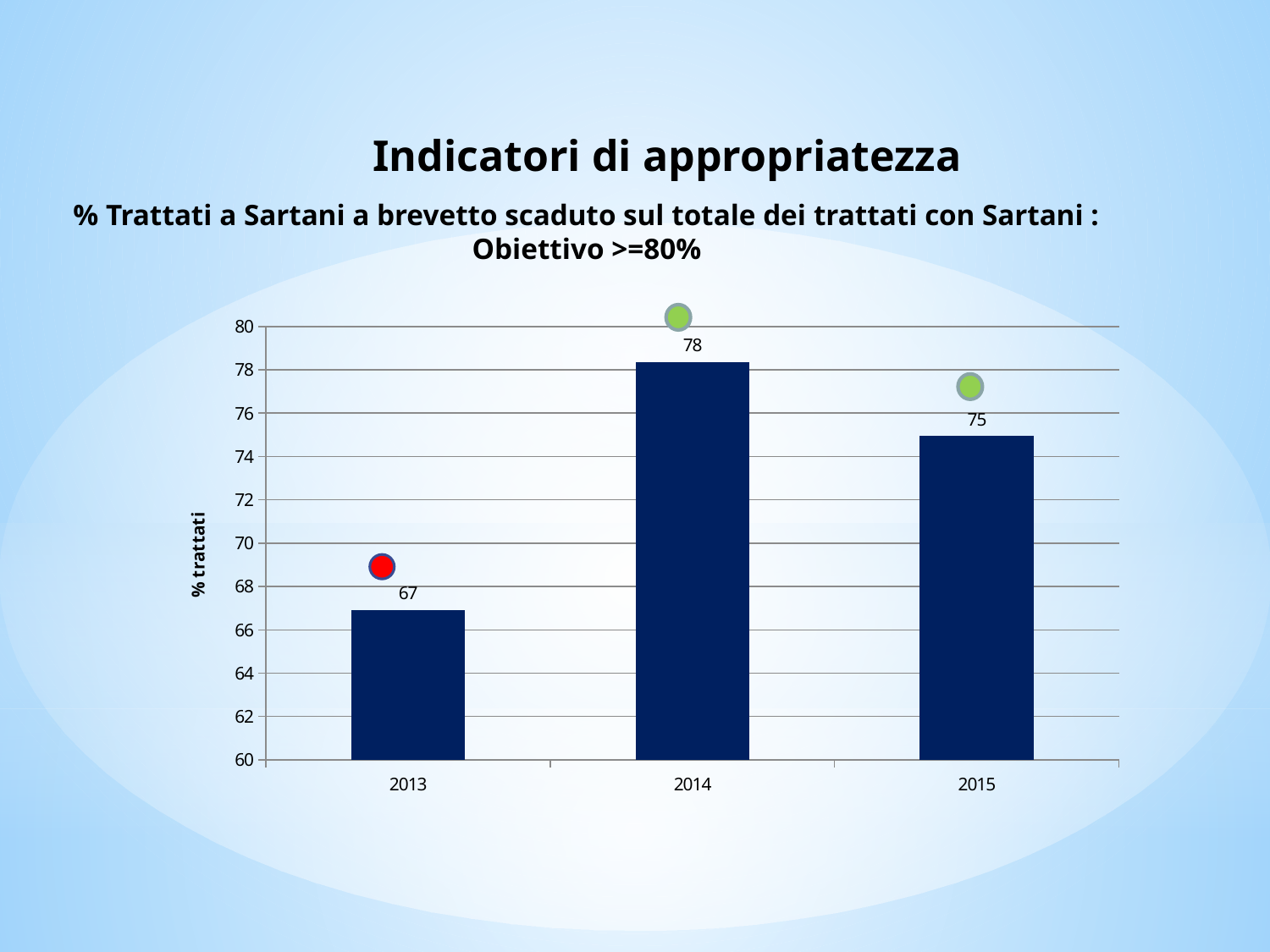
What is the difference between the values for 2014 and 2013? 11 Which year has the lowest value? 2013 What is the value for 2015? 75 How many years are shown on the x axis? 3 What kind of chart is shown on the slide? bar chart What is the value for 2013? 67 Is the value for 2014 greater or less than 70? greater Which is larger, the value for 2015 or the value for 2013? 2015 What is the label of the vertical axis? % trattati What is the value for 2014? 78 What is the difference between the values for 2014 and 2015? 3 Which year has the highest value? 2014